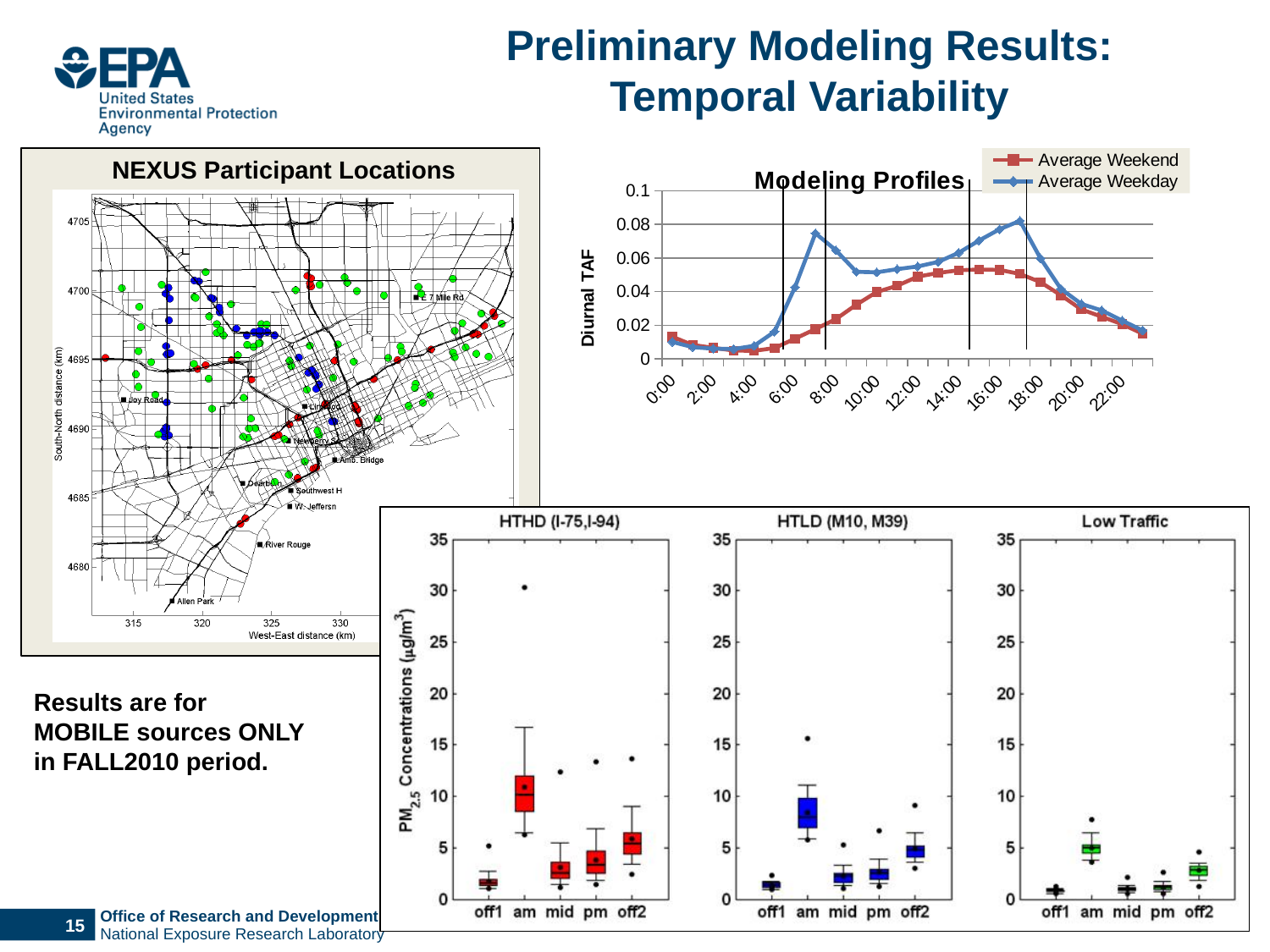
In the Modeling Profiles chart, how many series does the legend list? 2 In the Modeling Profiles chart, what is the label on the vertical axis? Diurnal TAF In the Modeling Profiles chart, is the Average Weekday value at 7:00 greater or less than 0.06? greater In the Modeling Profiles chart, does the Average Weekend series rise or fall between 4:00 and 14:00? rise In the HTHD (I-75,I-94) box plot panel, which time period has the highest median PM2.5 concentration? am In the Modeling Profiles chart, is the Average Weekend value at 14:00 greater or less than 0.04? greater In the box plot panels at the bottom of the slide, how many time-period categories are shown on the x axis of each panel? 5 In the Modeling Profiles chart, how many time labels are shown on the horizontal axis? 12 What kind of chart is the Modeling Profiles chart? line chart In the HTLD (M10, M39) box plot panel, is the median PM2.5 concentration for am greater or less than 5? greater In the Modeling Profiles chart, which series has the larger value at 7:00, Average Weekday or Average Weekend? Average Weekday